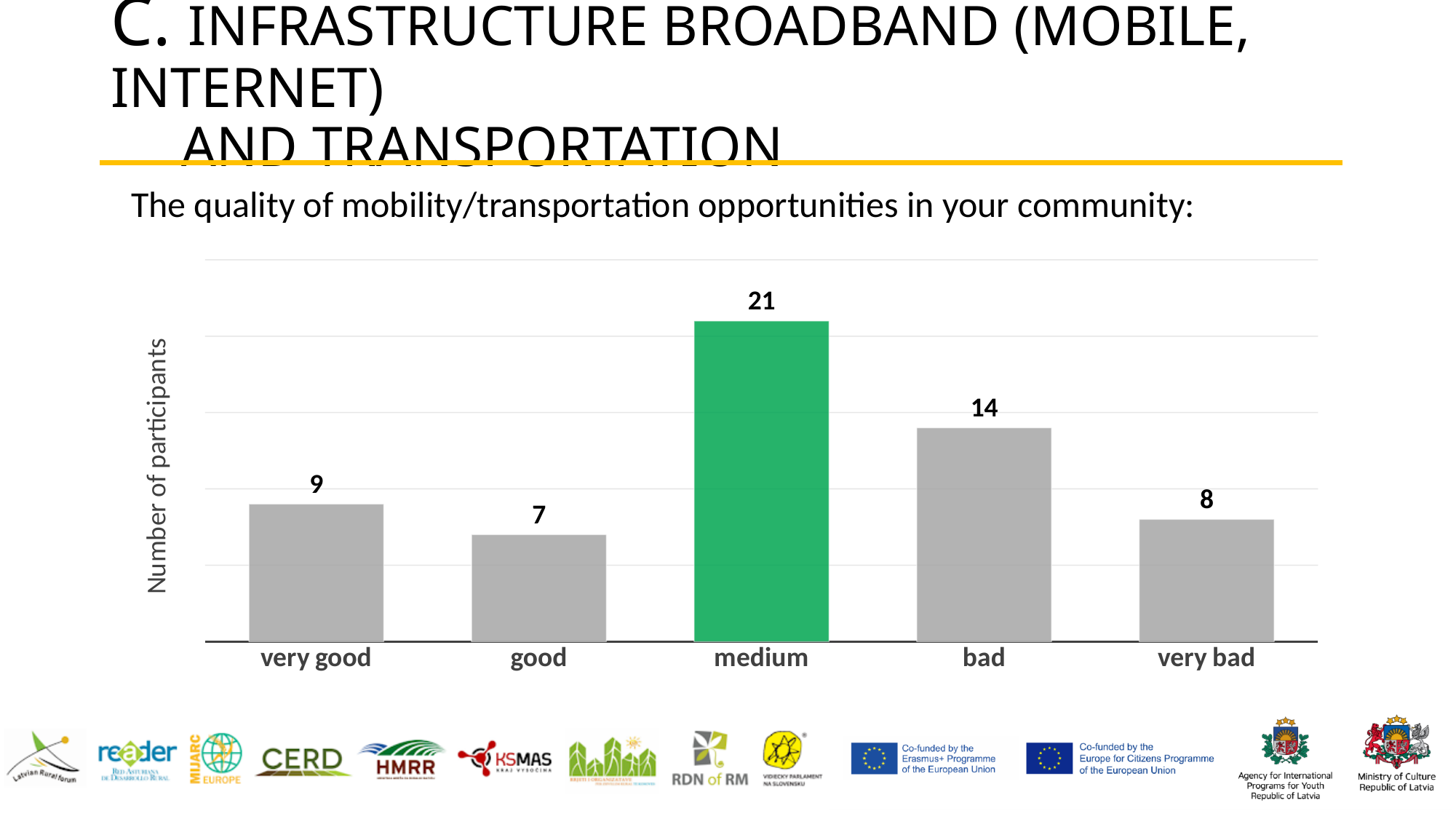
Which has more participants, "very bad" or "good"? very bad What is the difference in number of participants between "medium" and "bad"? 7 Which category has the highest number of participants? medium What is the number of participants for the "very good" category? 9 What is the difference in number of participants between "very good" and "good"? 2 How many categories are shown on the x axis of the chart? 5 What kind of chart is shown on the slide? bar chart What is the number of participants for the "bad" category? 14 Which bar is highlighted in green rather than grey? medium How many participants rated the quality of mobility/transportation opportunities as "medium"? 21 What is the total number of participants across all five categories? 59 Which category has the lowest number of participants? good